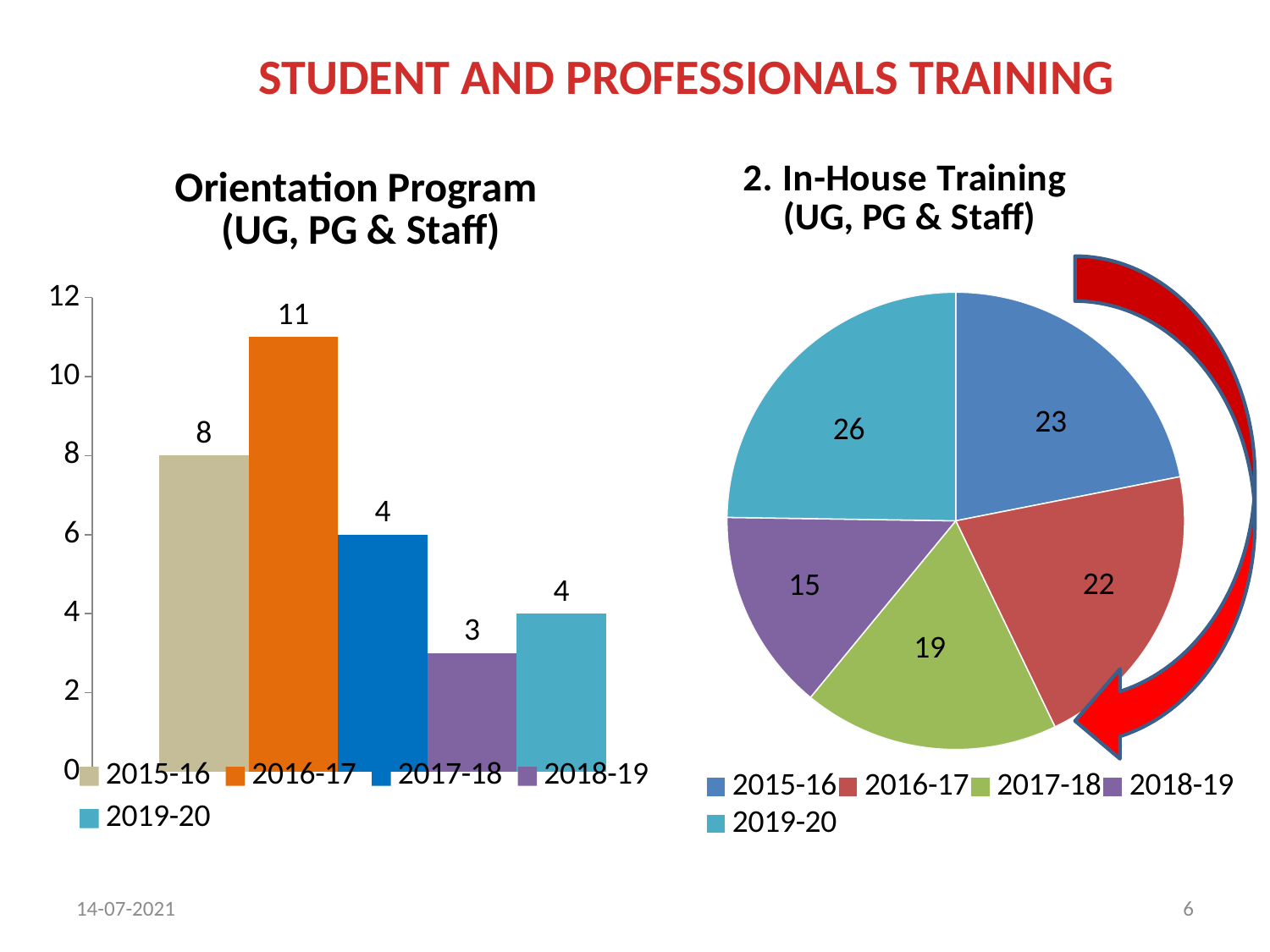
In the Orientation Program chart, what is the difference between the values for 2016-17 and 2015-16? 3 In the Orientation Program chart, what is the value for 2016-17? 11 In the Orientation Program chart, what is the value for 2015-16? 8 In the Orientation Program chart, which year has the highest value? 2016-17 In the In-House Training chart, what is the value for 2019-20? 26 In the In-House Training chart, which is larger, the value for 2015-16 or 2016-17? 2015-16 How many entries does the legend of the In-House Training chart list? 5 In the In-House Training chart, which year has the largest slice? 2019-20 In the In-House Training chart, what is the value for 2017-18? 19 In the Orientation Program chart, which year has the lowest value? 2018-19 What kind of chart is the Orientation Program chart? Bar chart In the In-House Training chart, which year has the smallest slice? 2018-19